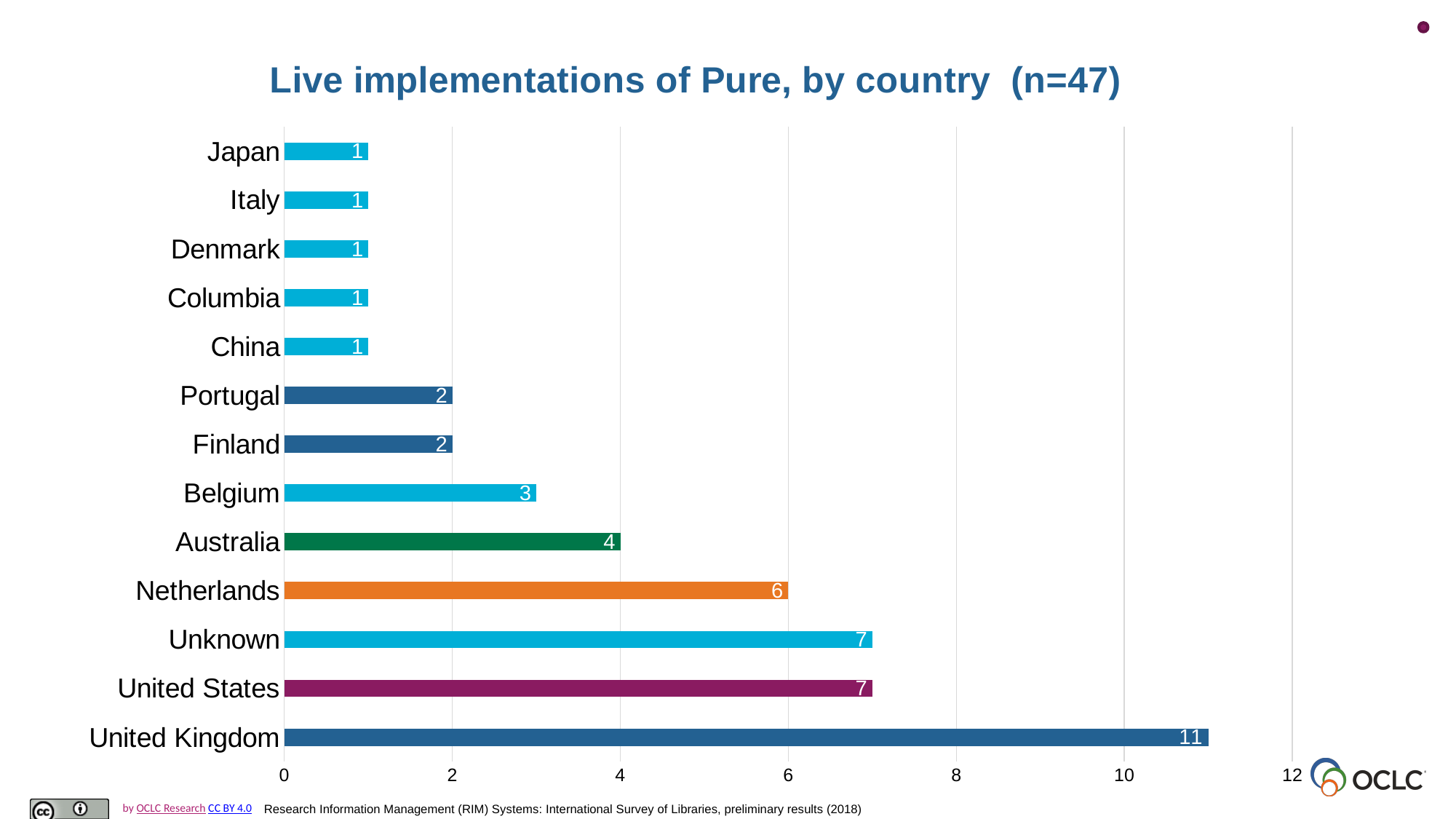
What is the value for Australia? 4 Which country has the highest number of live implementations of Pure? United Kingdom What is the value for the Netherlands? 6 What is the difference between the values for the Netherlands and Australia? 2 Is the value for the United Kingdom greater or less than 10? greater What is the title of the chart? Live implementations of Pure, by country (n=47) What is the value for the United Kingdom? 11 Which is larger, the value for Belgium or the value for Finland? Belgium How many categories are shown on the chart? 13 What is the difference between the values for the United Kingdom and the United States? 4 What is the value for Belgium? 3 What kind of chart is shown on the slide? bar chart